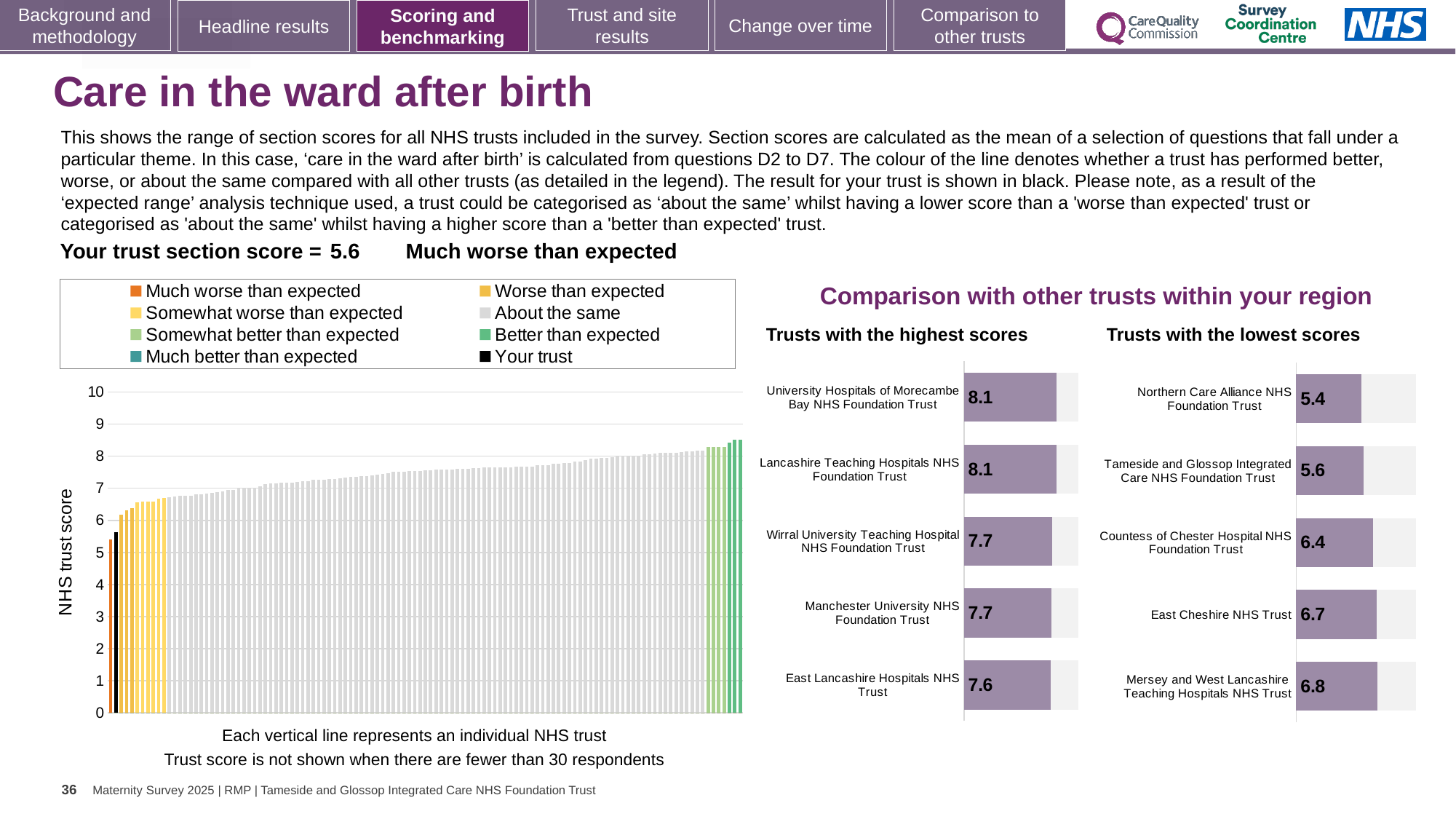
In the 'Trusts with the lowest scores' chart, which trust has the lowest score? Northern Care Alliance NHS Foundation Trust What kind of chart is the 'Trusts with the lowest scores' chart? bar chart In the main 'NHS trust score' chart on the left, do the bar values rise or fall from left to right? rise In the 'Trusts with the highest scores' chart, which trust has the lowest score shown? East Lancashire Hospitals NHS Trust In the main 'NHS trust score' chart on the left, is the value of the tallest bar greater or less than 8? greater In the 'Trusts with the highest scores' chart, what is the score for University Hospitals of Morecambe Bay NHS Foundation Trust? 8.1 In the 'Trusts with the highest scores' chart, what is the difference between the score for University Hospitals of Morecambe Bay NHS Foundation Trust and East Lancashire Hospitals NHS Trust? 0.5 In the 'Trusts with the lowest scores' chart, which has the higher score: Countess of Chester Hospital NHS Foundation Trust or East Cheshire NHS Trust? East Cheshire NHS Trust In the 'Trusts with the lowest scores' chart, what is the score for Countess of Chester Hospital NHS Foundation Trust? 6.4 How many trusts are listed in the 'Trusts with the highest scores' chart? 5 In the 'Trusts with the lowest scores' chart, what is the difference between the scores for Mersey and West Lancashire Teaching Hospitals NHS Trust and Northern Care Alliance NHS Foundation Trust? 1.4 How many entries does the legend of the main 'NHS trust score' chart list? 8